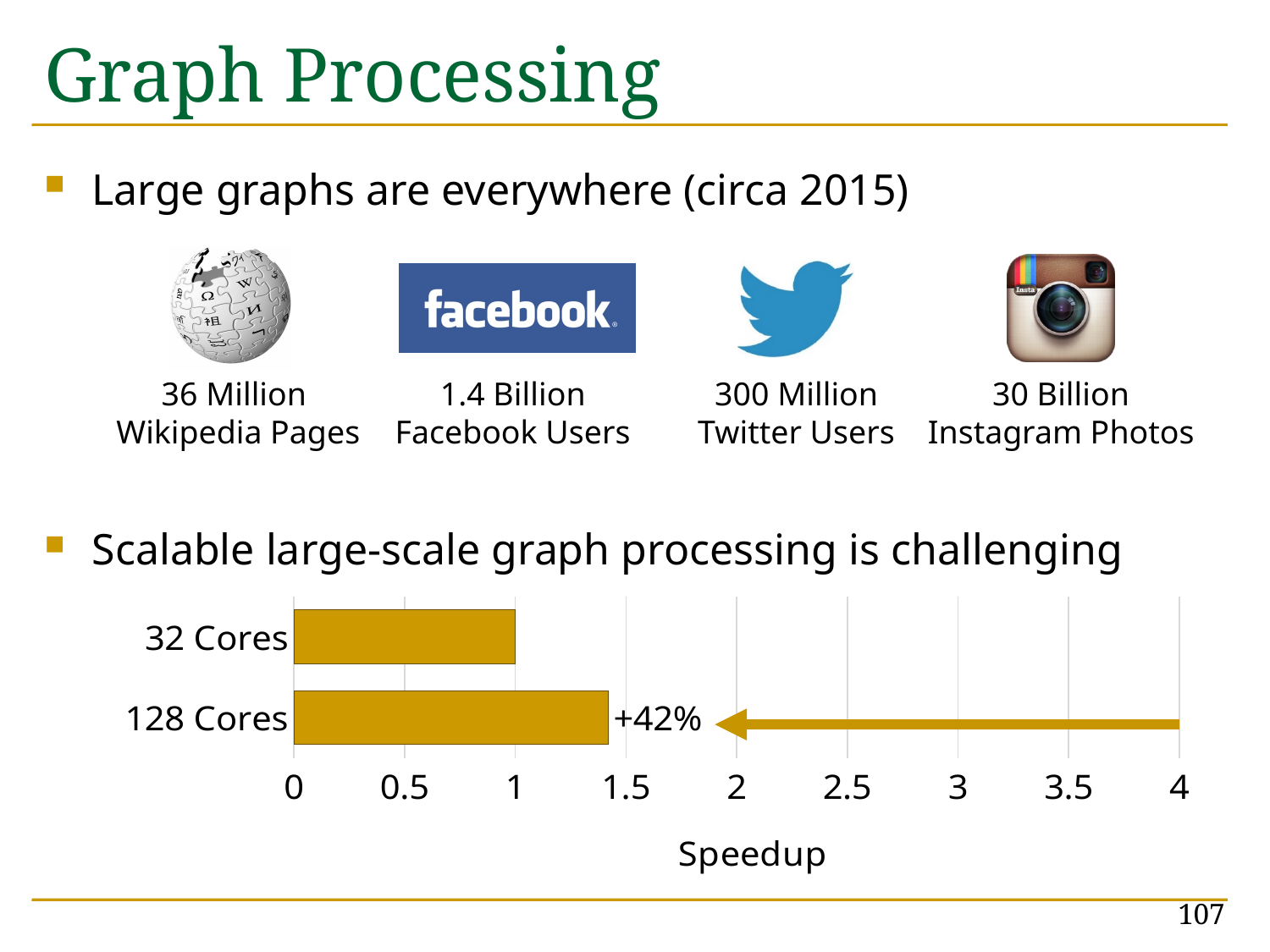
Is the speedup for 128 Cores greater or less than 1? greater What is the highest value shown on the Speedup axis? 4 Which category has the higher speedup, 32 Cores or 128 Cores? 128 Cores What annotation is printed next to the 128 Cores bar? +42% What kind of chart is shown at the bottom of the slide? bar chart Which category has the highest speedup in the chart? 128 Cores Is the speedup for 32 Cores greater or less than 2? less Is the speedup for 128 Cores greater or less than 1.5? less How many categories does the Speedup bar chart show? 2 Which category has the lowest speedup in the chart? 32 Cores What is the speedup value for 32 Cores? 1 What is the title of the horizontal axis of the chart? Speedup